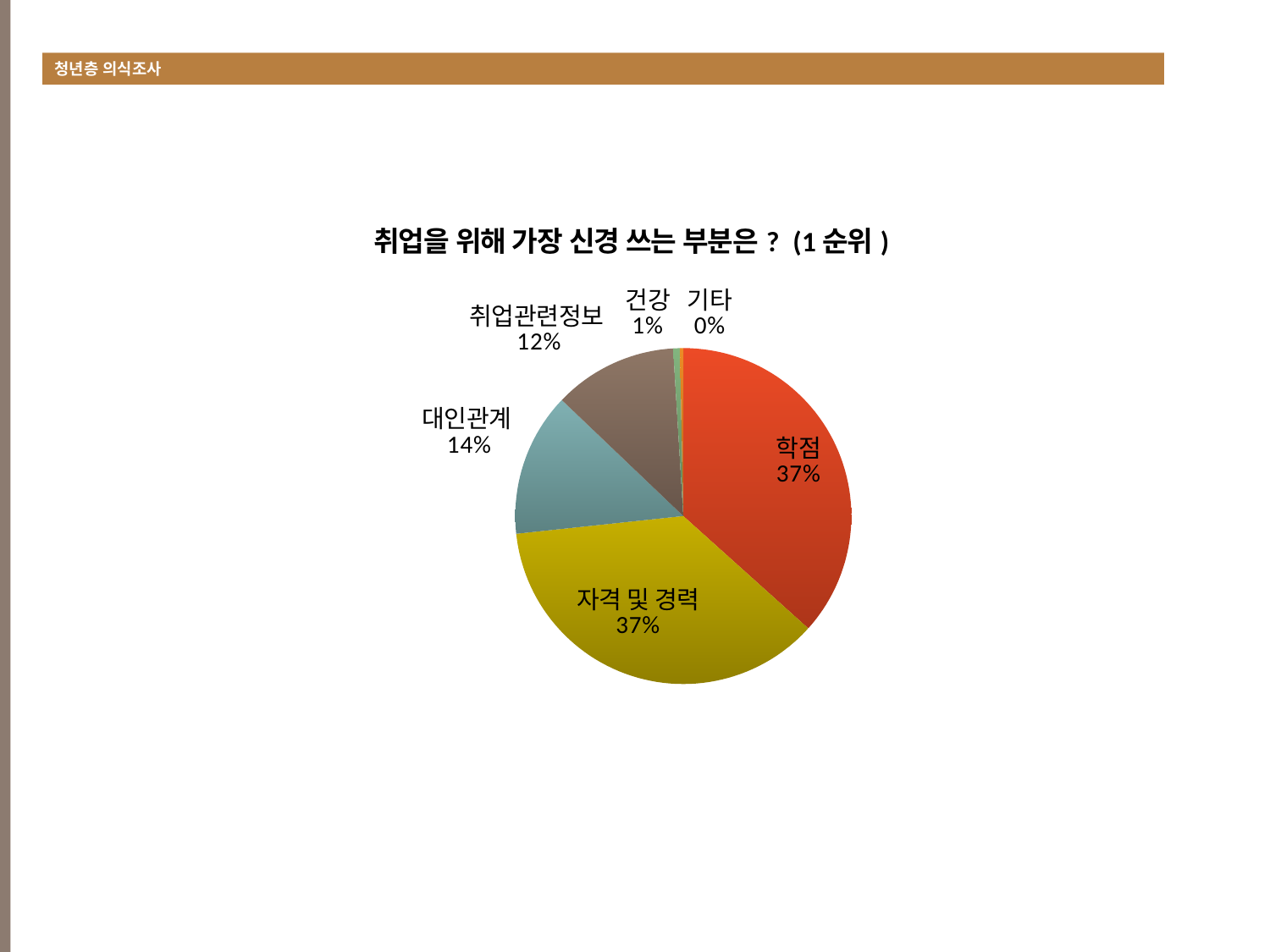
What kind of chart is shown on the slide? pie chart What is the combined share of 학점 and 자격 및 경력? 74% What is the title of the chart? 취업을 위해 가장 신경 쓰는 부분은 ? (1 순위 ) What is the value shown for 대인관계? 14% Which category has the smallest share of the pie? 기타 What is the value shown for 취업관련정보? 12% Which is larger, the share for 대인관계 or the share for 취업관련정보? 대인관계 What is the difference between the shares of 대인관계 and 취업관련정보? 2% How many categories are shown in the pie chart? 6 What share of the pie does 학점 take? 37% What is the value shown for 건강? 1% What share of the pie does 자격 및 경력 take? 37%